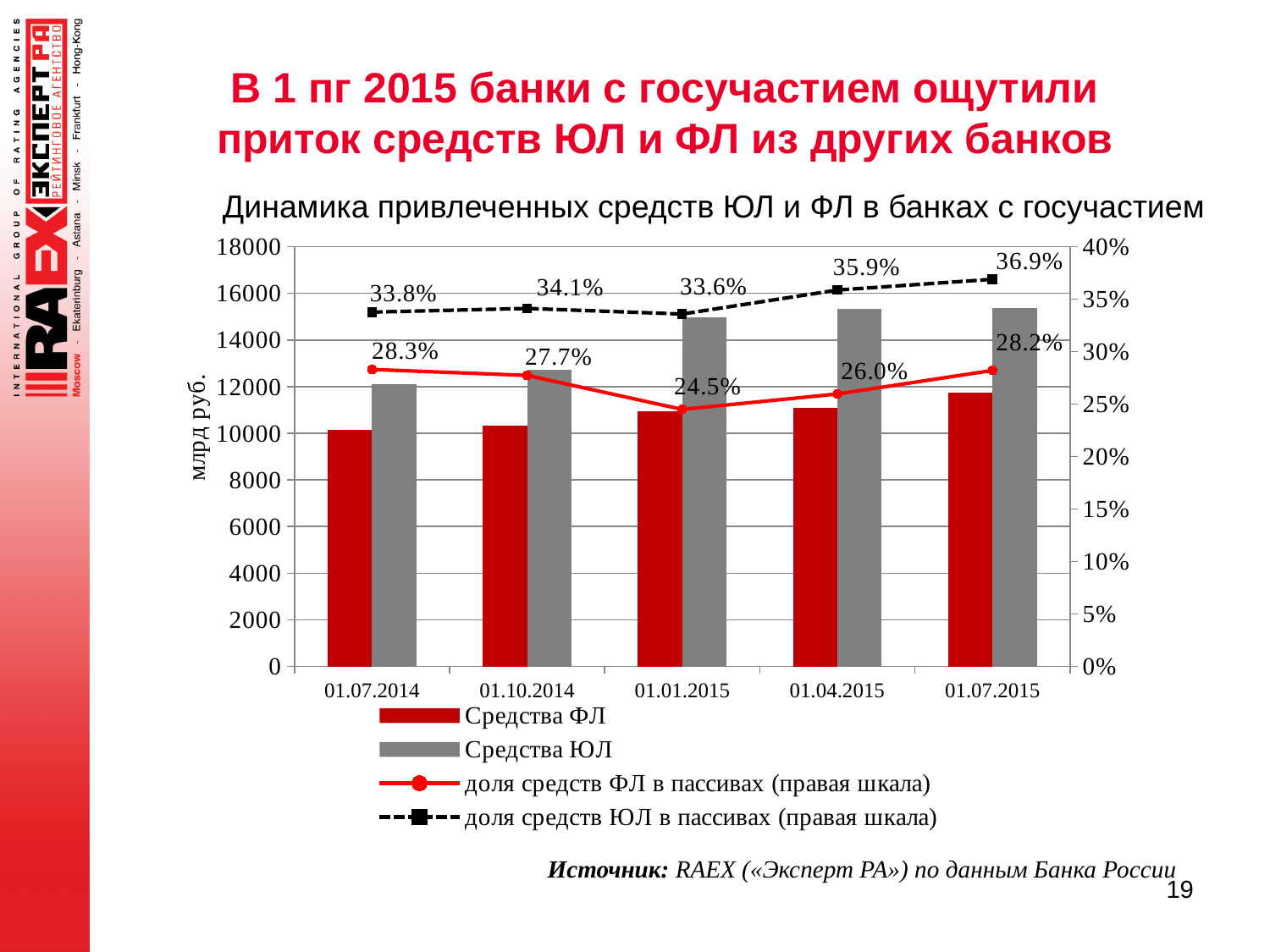
What is the share of ФЛ funds in liabilities (доля средств ФЛ в пассивах) on 01.01.2015? 24.5% On which date is the share of ФЛ funds in liabilities the lowest? 01.01.2015 How many dates are shown on the x axis of the chart? 5 Does the share of ЮЛ funds in liabilities rise or fall from 01.01.2015 to 01.07.2015? rise What kind of chart is shown on the slide? Combined bar and line chart On which date is the share of ЮЛ funds in liabilities the highest? 01.07.2015 Is the value of Средства ЮЛ on 01.01.2015 greater or less than 14000? greater How many series does the chart legend list? 4 What is the share of ЮЛ funds in liabilities (доля средств ЮЛ в пассивах) on 01.07.2015? 36.9% Is the value of Средства ФЛ on 01.07.2014 greater or less than 12000? less Which is larger: the share of ЮЛ funds in liabilities on 01.10.2014 or on 01.01.2015? 01.10.2014 By how many percentage points did the share of ЮЛ funds in liabilities change from 01.07.2014 to 01.07.2015? 3.1 percentage points